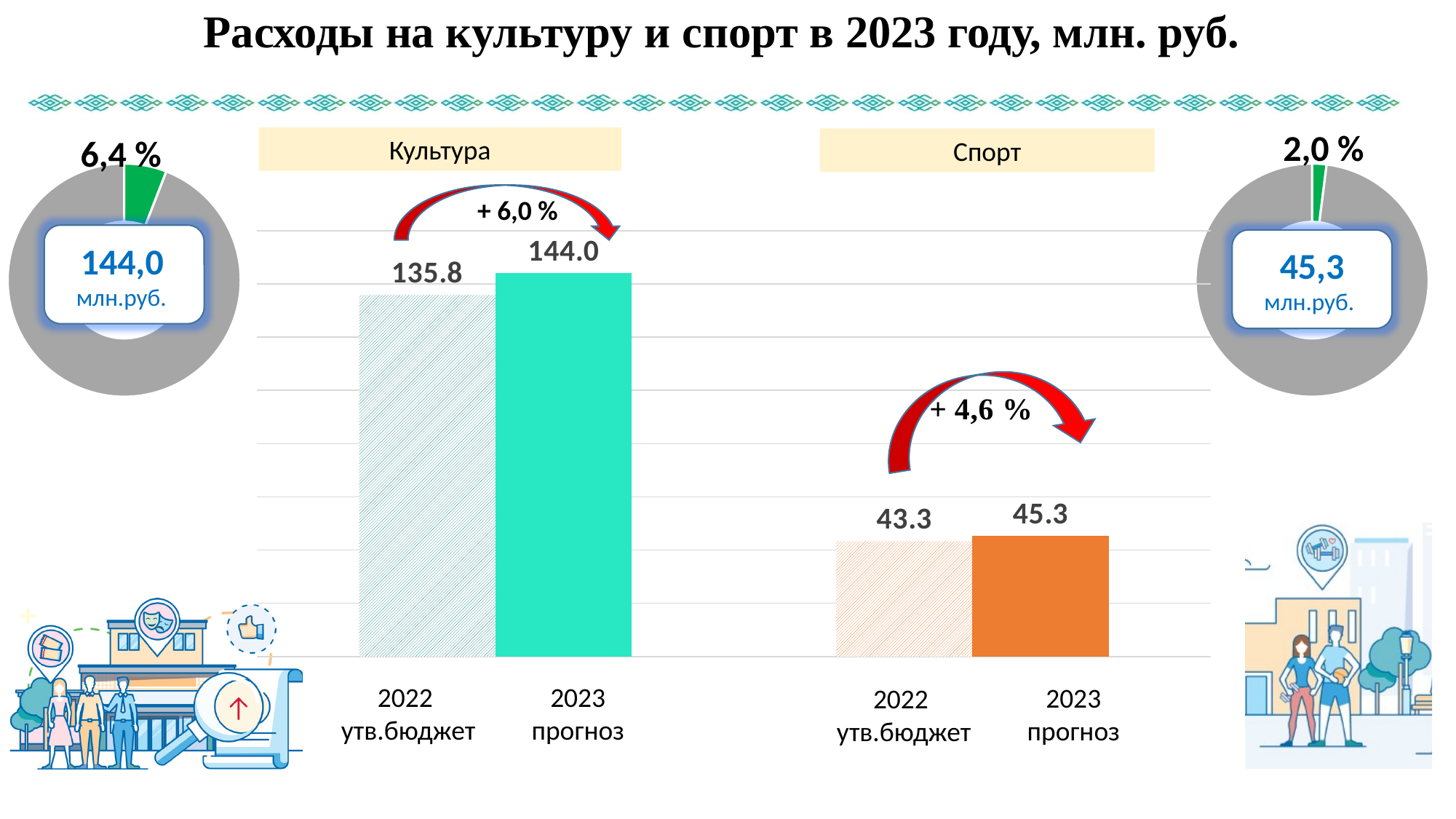
In the Культура bar chart, what is the value for 2022 утв.бюджет? 135.8 In the Культура bar chart, do the values rise or fall from 2022 утв.бюджет to 2023 прогноз? rise In the Культура bar chart, which category has the lowest value? 2022 утв.бюджет In the Спорт bar chart, what is the value for 2023 прогноз? 45.3 In the Спорт bar chart, which category has the higher value, 2022 утв.бюджет or 2023 прогноз? 2023 прогноз What kind of chart is used to show the Культура values? bar chart In the Спорт bar chart, what is the difference between the 2023 прогноз and 2022 утв.бюджет values? 2.0 In the Культура bar chart, what is the value for 2023 прогноз? 144.0 How many categories are shown in the Спорт bar chart? 2 In the Культура bar chart, what is the difference between the 2023 прогноз and 2022 утв.бюджет values? 8.2 In the Спорт bar chart, what is the value for 2022 утв.бюджет? 43.3 What percentage share is shown on the donut chart at the top right of the slide, next to the Спорт chart? 2,0 %